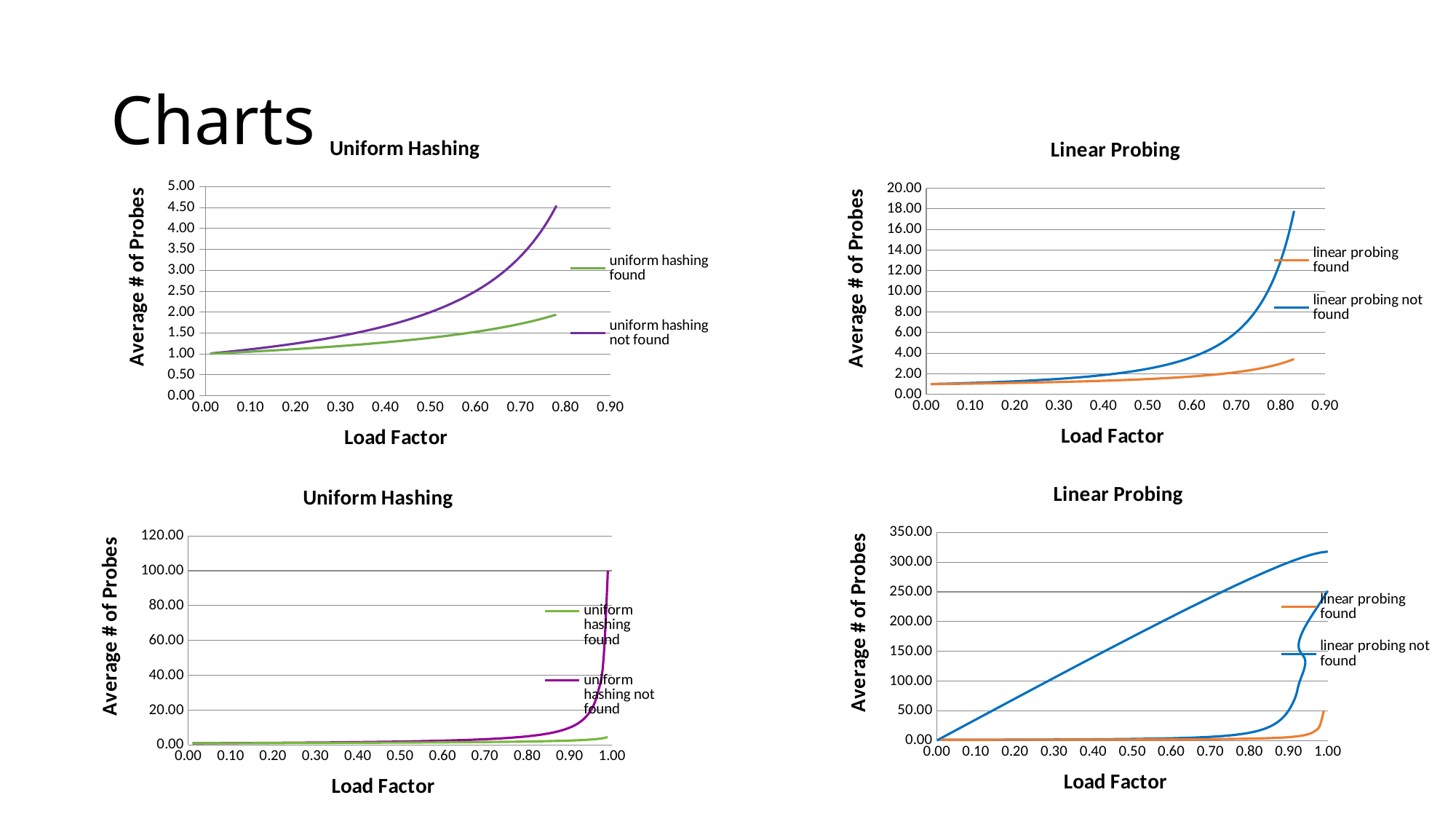
In the bottom-right Linear Probing chart, is the value of 'linear probing found' at a load factor of 0.80 greater or less than 50.00? less What are the two legend entries on the top-left Uniform Hashing chart? uniform hashing found; uniform hashing not found In the top-left Uniform Hashing chart, is the value of 'uniform hashing found' at a load factor of 0.70 greater or less than 2.00? less In the top-right Linear Probing chart, which series is higher at a load factor of 0.80? linear probing not found In the bottom-left Uniform Hashing chart, is the peak value of 'uniform hashing not found' greater or less than 80.00? greater In the top-left Uniform Hashing chart, does the 'uniform hashing not found' line rise or fall as the load factor increases? rises In the bottom-right Linear Probing chart, which series reaches the higher value? linear probing not found How many charts are shown on the slide? 4 How many series does the legend of the top-right Linear Probing chart list? 2 What kind of chart is the top-left Uniform Hashing chart? line chart What is the x-axis title of the bottom-left Uniform Hashing chart? Load Factor